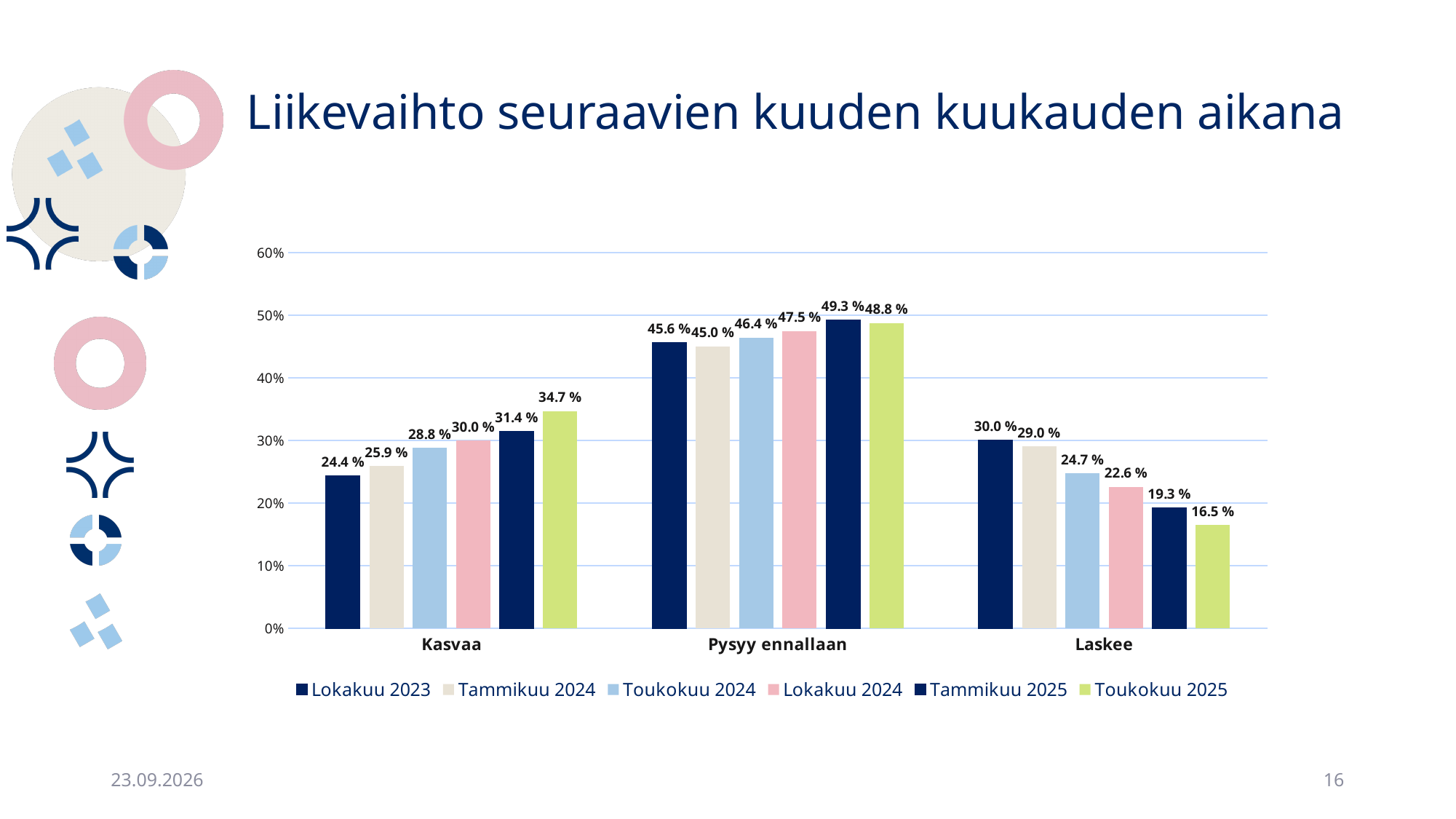
What is the difference between the Toukokuu 2025 and Lokakuu 2023 values in the Kasvaa category? 10.3 % In the Pysyy ennallaan category, which is larger: the Tammikuu 2025 value or the Toukokuu 2025 value? Tammikuu 2025 What is the value for Lokakuu 2024 in the Laskee category? 22.6 % How many categories are shown on the x axis? 3 Do the values in the Laskee category rise or fall from Lokakuu 2023 to Toukokuu 2025? Fall Which series has the lowest value in the Kasvaa category? Lokakuu 2023 Which series has the highest value in the Laskee category? Lokakuu 2023 What is the value for Toukokuu 2025 in the Kasvaa category? 34.7 % What is the value for Tammikuu 2025 in the Pysyy ennallaan category? 49.3 % What kind of chart is shown on the slide? Bar chart What is the title of the slide? Liikevaihto seuraavien kuuden kuukauden aikana How many series does the legend list? 6